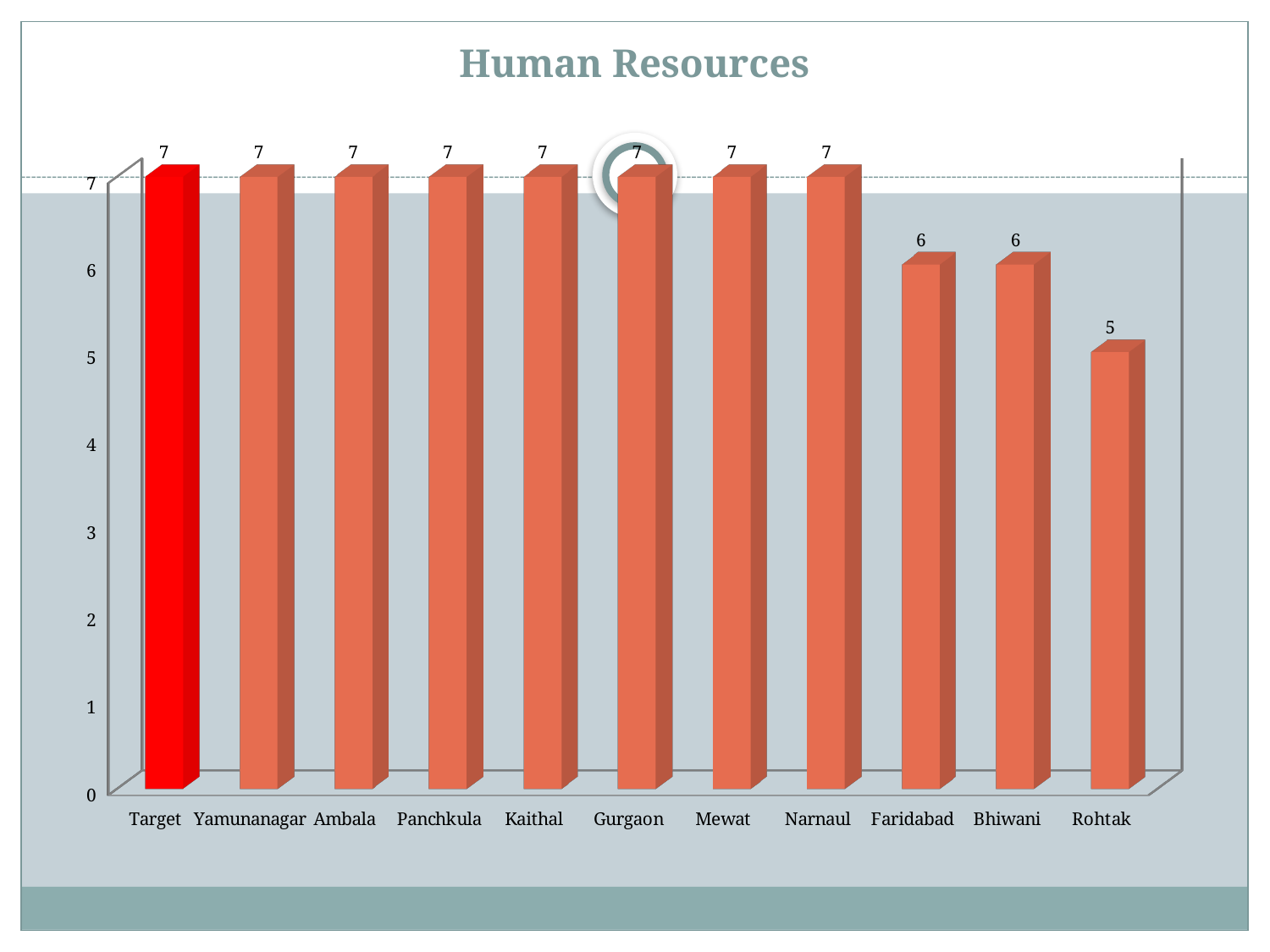
Which bar is coloured differently (bright red) from the others? Target Which category has the lowest value? Rohtak What is the value for Target? 7 What is the value for Faridabad? 6 How many categories are shown on the x axis? 11 What kind of chart is this? Bar chart What is the title of the chart? Human Resources Which is larger, the value for Mewat or the value for Bhiwani? Mewat What is the difference between the Target value and the Rohtak value? 2 What is the difference between the values for Narnaul and Faridabad? 1 What is the value for Bhiwani? 6 What is the value for Rohtak? 5